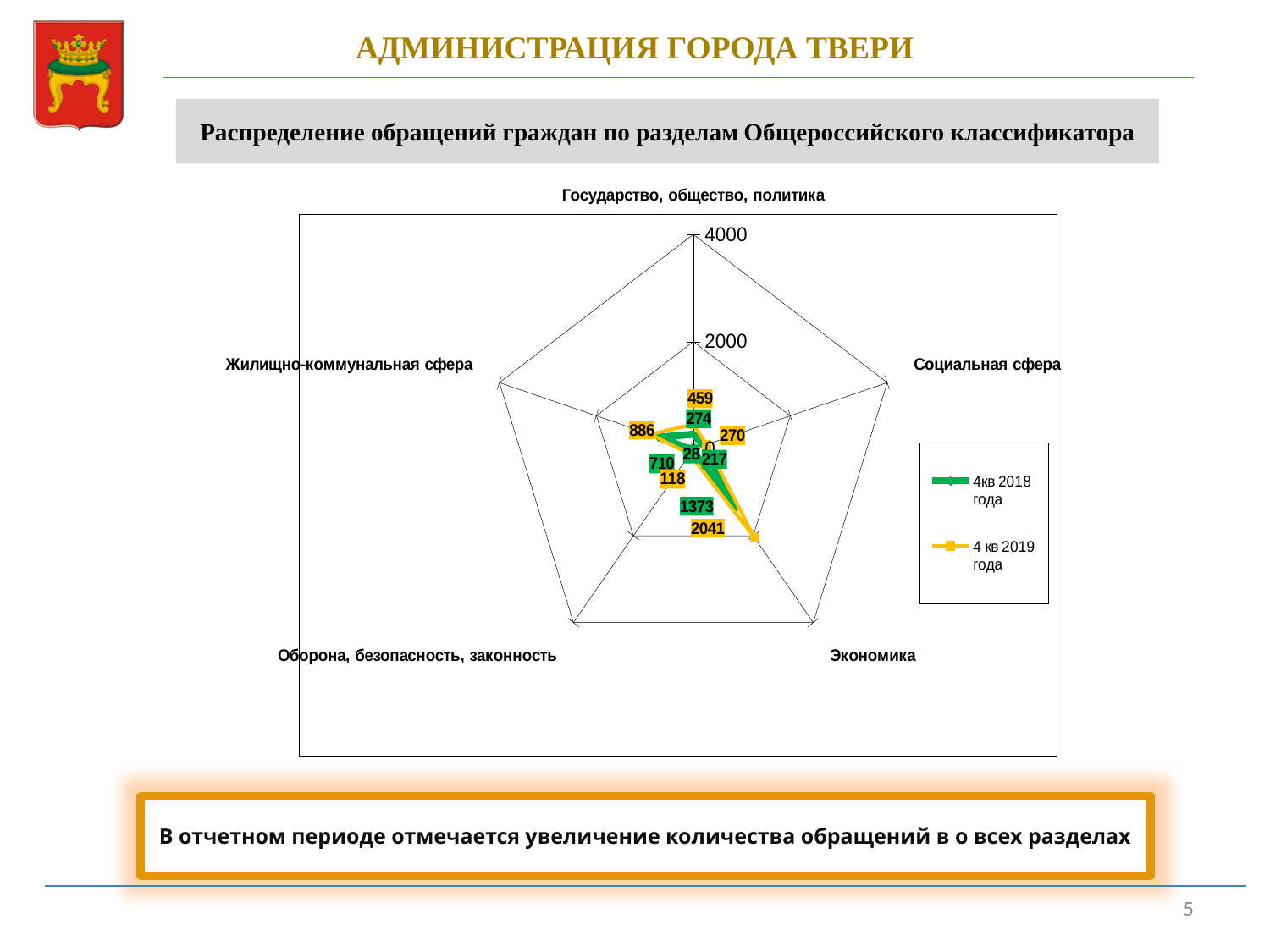
What is the value for Государство, общество, политика in the 4 кв 2019 года series? 459 What is the difference between the 4 кв 2019 года and 4кв 2018 года values for Экономика? 668 Is the value for Экономика in the 4 кв 2019 года series greater or less than 2000? greater What is the value for Социальная сфера in the 4кв 2018 года series? 217 Which is larger for Государство, общество, политика: the 4кв 2018 года value or the 4 кв 2019 года value? 4 кв 2019 года What is the value for Экономика in the 4 кв 2019 года series? 2041 Which category has the highest value in the 4 кв 2019 года series? Экономика What is the value for Жилищно-коммунальная сфера in the 4 кв 2019 года series? 886 How many categories (axes) does the radar chart have? 5 What is the value for Экономика in the 4кв 2018 года series? 1373 How many series does the legend list? 2 What kind of chart is shown on the slide? radar chart